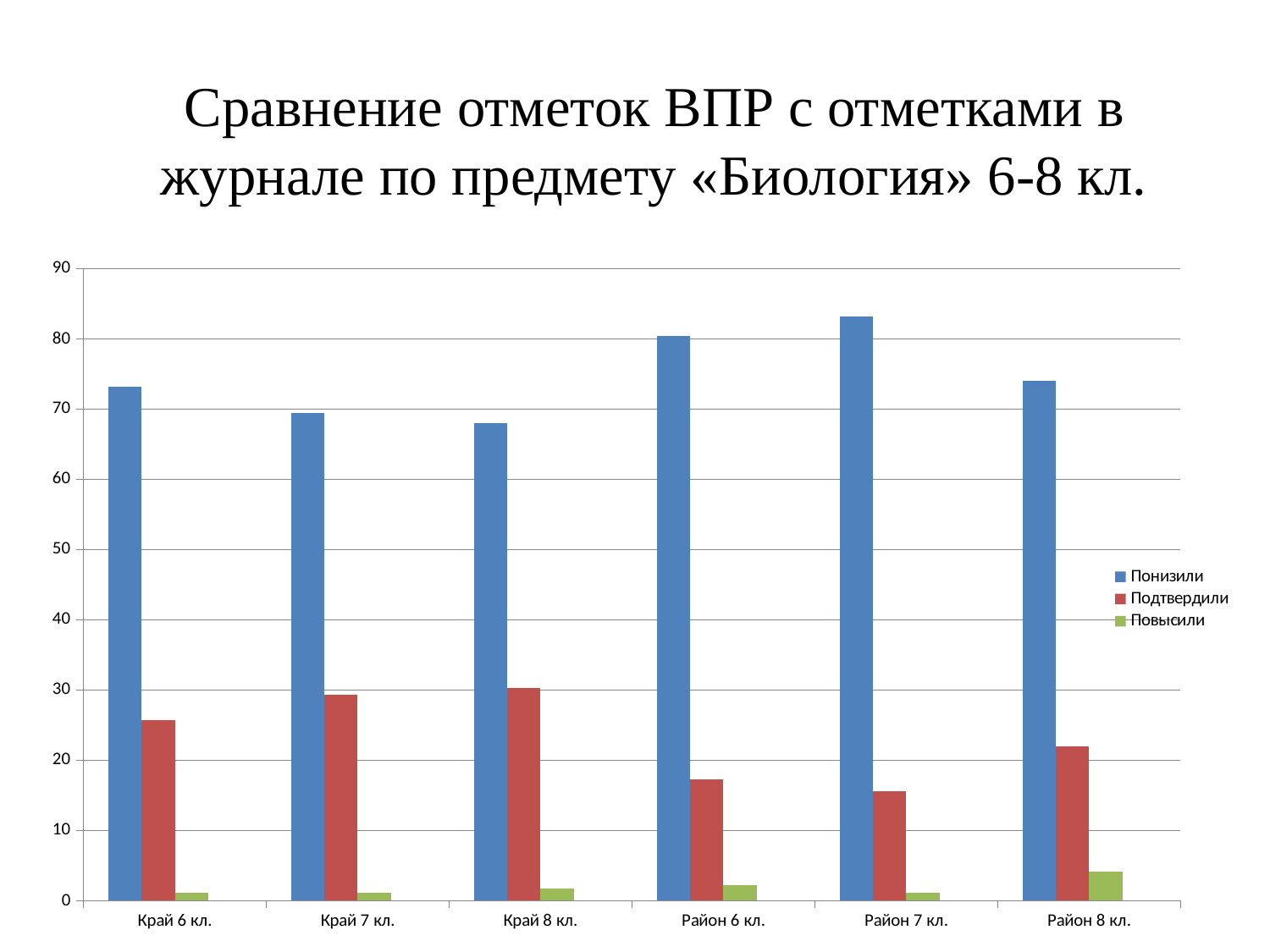
What type of chart is shown on the slide? bar chart Is the value of Подтвердили for Район 6 кл. greater or less than 20? less Is the value of Понизили for Район 7 кл. greater or less than 80? greater Which is larger: the value of Понизили for Район 6 кл. or for Край 6 кл.? Район 6 кл. How many series does the legend list? 3 Which series is shown in green in the legend? Повысили Is the value of Подтвердили for Край 6 кл. greater or less than 20? greater How many categories are shown on the x axis of the chart? 6 Which category has the highest value for the series Повысили? Район 8 кл. Which category has the highest value for the series Понизили? Район 7 кл. Which is larger: the value of Подтвердили for Край 7 кл. or for Район 8 кл.? Край 7 кл.